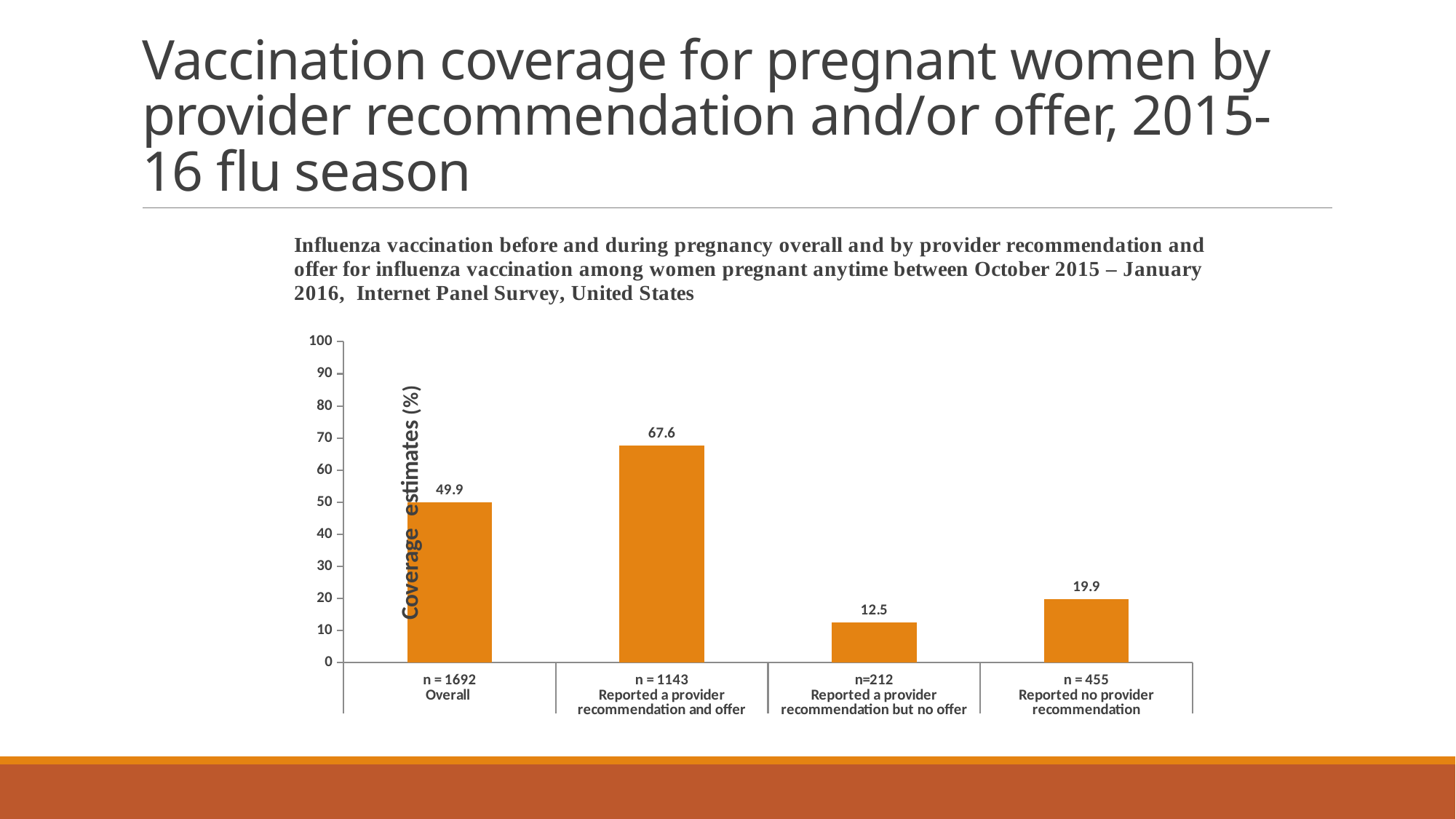
What is the difference in coverage estimates between the 'Reported no provider recommendation' group and the 'Reported a provider recommendation but no offer' group? 7.4 What is the coverage estimate for women who reported a provider recommendation and offer? 67.6 Which group has the lowest coverage estimate? Reported a provider recommendation but no offer What is the coverage estimate for the Overall group (n = 1692)? 49.9 Which has a higher coverage estimate: 'Reported no provider recommendation' or 'Reported a provider recommendation but no offer'? Reported no provider recommendation Which group has the highest coverage estimate? Reported a provider recommendation and offer What is the coverage estimate for women who reported no provider recommendation? 19.9 What is the label of the vertical axis of the chart? Coverage estimates (%) What is the coverage estimate for women who reported a provider recommendation but no offer? 12.5 What is the difference in coverage estimates between the 'Reported a provider recommendation and offer' group and the Overall group? 17.7 How many groups (bars) are shown in the chart? 4 What type of chart is shown on the slide? Bar chart